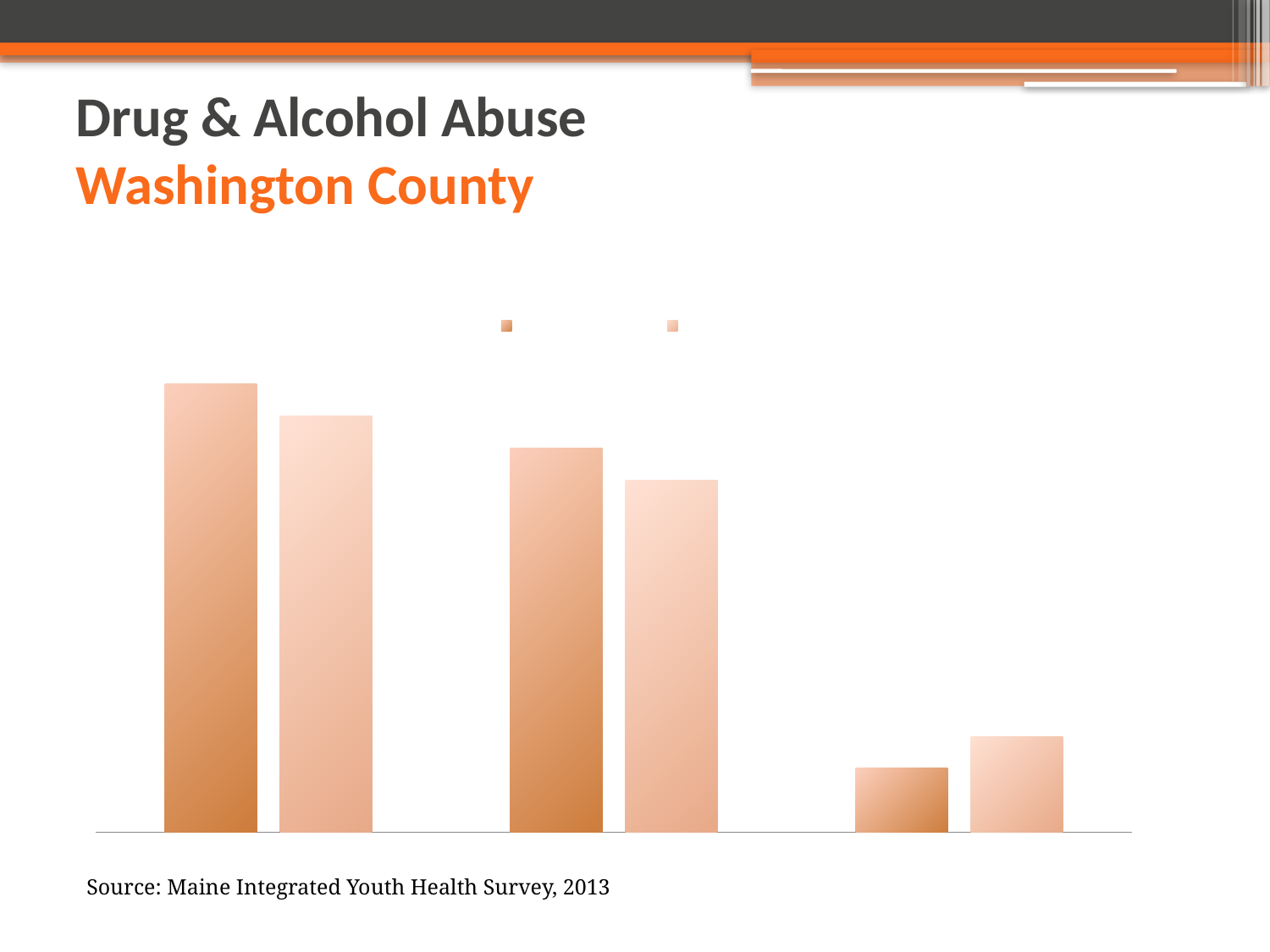
What is the title of the slide containing the chart? Drug & Alcohol Abuse Washington County What source is cited below the chart? Maine Integrated Youth Health Survey, 2013 In the rightmost group, which bar is taller: the darker left bar or the lighter right bar? the lighter right bar Do the bar heights rise or fall moving from the leftmost group to the rightmost group? fall How many groups of bars does the chart show? 3 How many series does the legend indicate? 2 How many bars are plotted in total on the chart? 6 In the leftmost group, which bar is taller: the darker left bar or the lighter right bar? the darker left bar What kind of chart is shown on the slide? bar chart Which group of bars is the shortest: the leftmost, middle, or rightmost? rightmost Which group of bars is the tallest: the leftmost, middle, or rightmost? leftmost